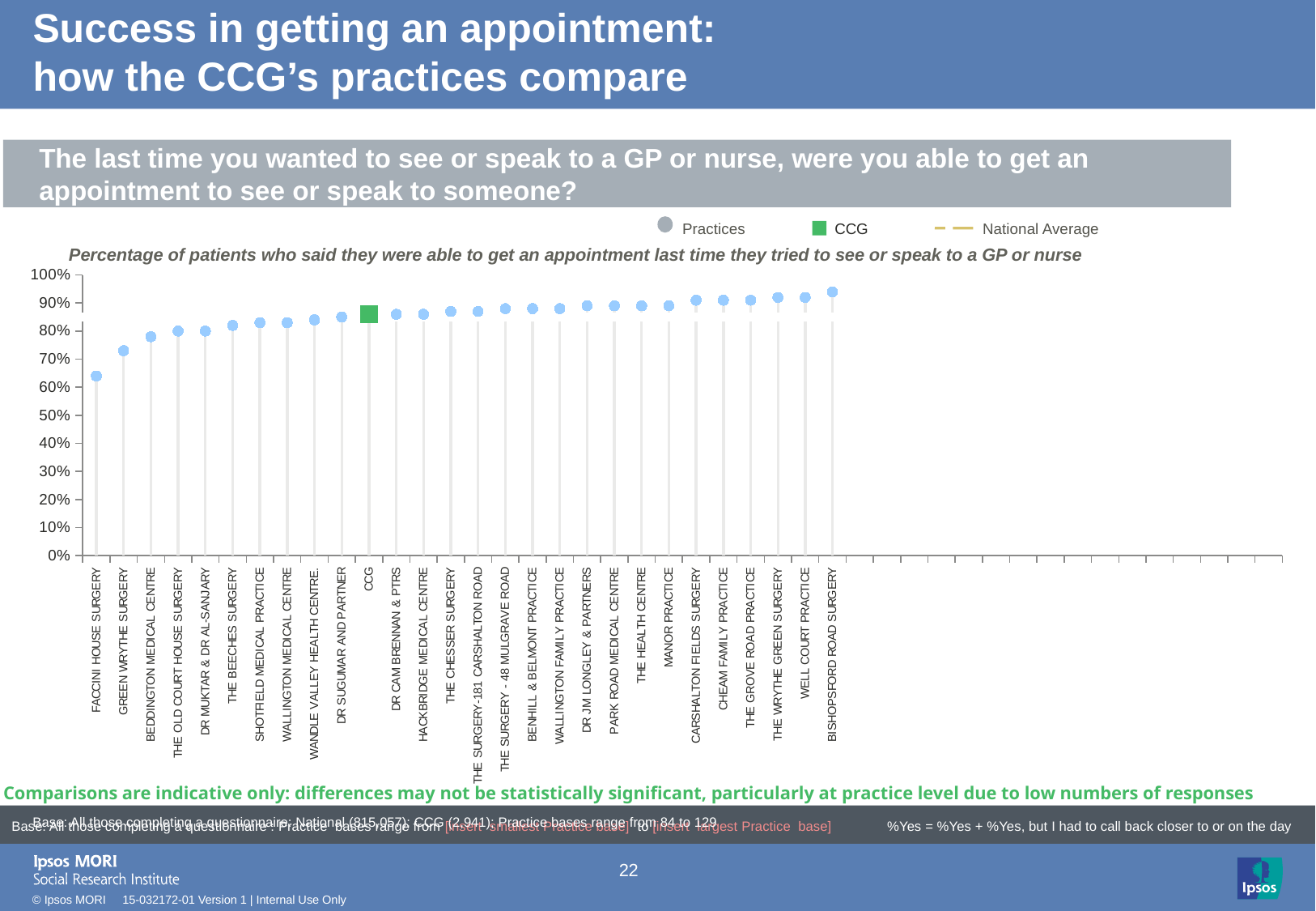
Is the value for BISHOPSFORD ROAD SURGERY greater or less than 90%? greater How many entries does the legend list? 3 Which has the larger value, CCG or BISHOPSFORD ROAD SURGERY? BISHOPSFORD ROAD SURGERY Is the value for CCG greater or less than 80%? greater Which practice has the highest percentage of patients who said they were able to get an appointment? BISHOPSFORD ROAD SURGERY Do the plotted values rise or fall from left to right along the x axis? rise Which practice has the lowest percentage of patients who said they were able to get an appointment? FACCINI HOUSE SURGERY Is the value for FACCINI HOUSE SURGERY greater or less than 70%? less How many labelled points (practices plus CCG) are plotted on the chart? 28 Which has the larger value, FACCINI HOUSE SURGERY or GREEN WRYTHE SURGERY? GREEN WRYTHE SURGERY What colour is the marker used for the CCG in the chart? Green